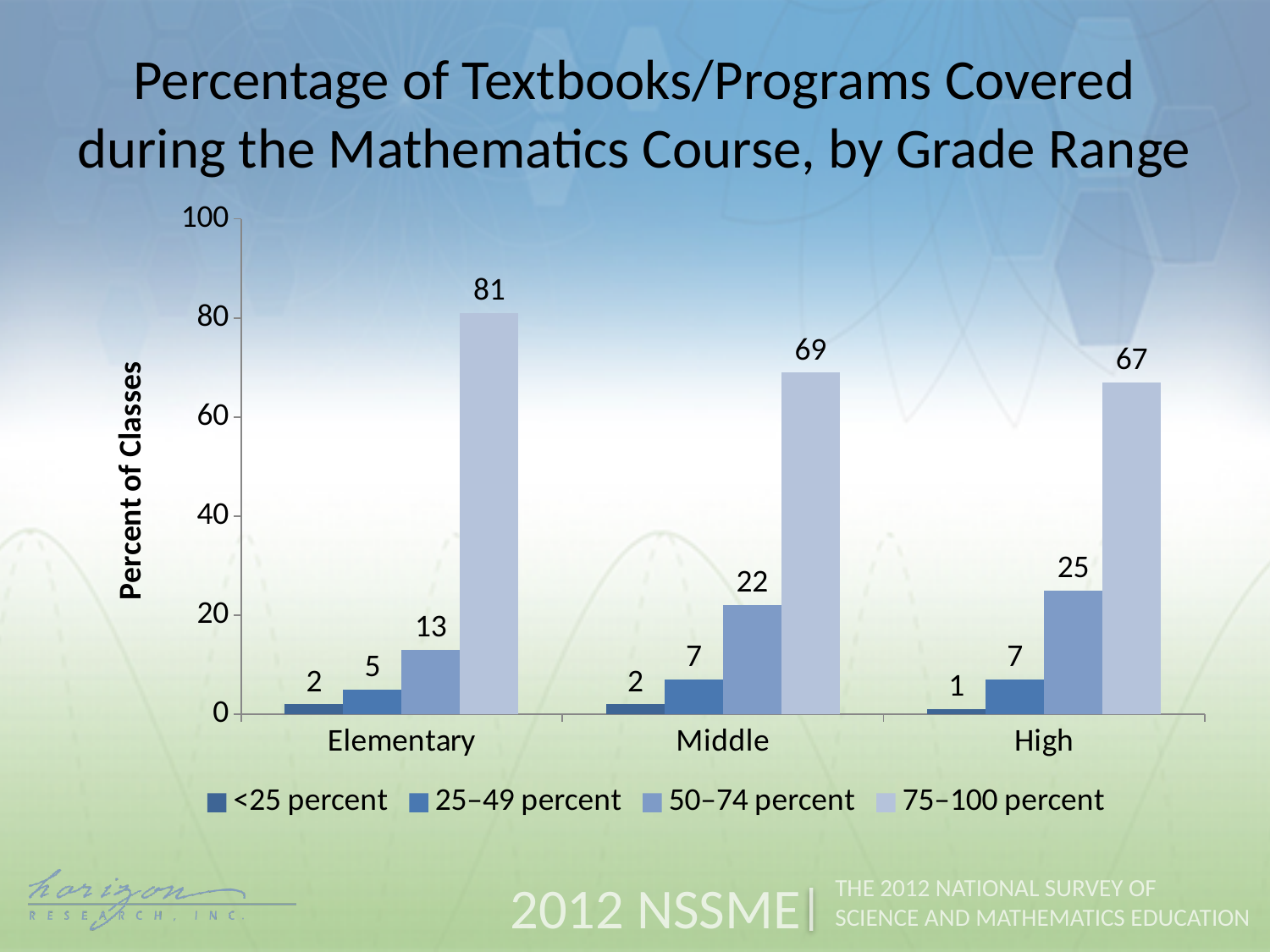
What kind of chart is shown on the slide? bar chart Which is larger: the 50–74 percent value for Middle or for High? High How many series does the legend list? 4 What is the value for 25–49 percent in the Middle grade range? 7 What is the value for 75–100 percent in the Elementary grade range? 81 What is the label of the y axis? Percent of Classes Which grade range has the highest value for 75–100 percent? Elementary How many grade ranges are shown on the x axis? 3 Is the value for 75–100 percent in the Middle grade range greater or less than 60? greater Which grade range has the lowest value for <25 percent? High What is the difference between the 75–100 percent values for Elementary and High? 14 What is the value for 50–74 percent in the High grade range? 25